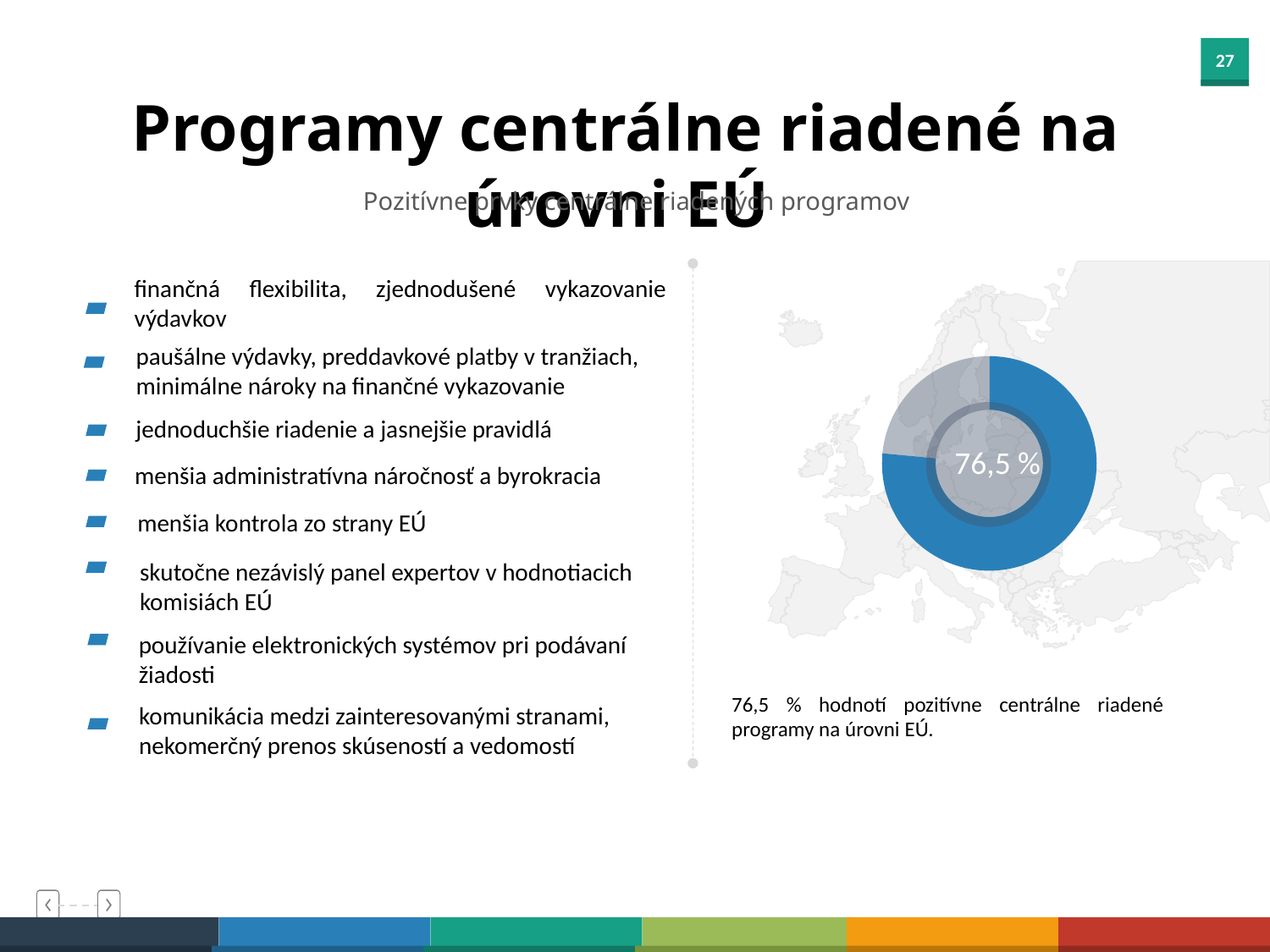
What share of respondents rate centrally managed programmes at EU level positively, according to the chart? 76,5 % What colour is the slice representing 76,5 % in the donut chart? Blue What kind of chart is shown on the right side of the slide? Pie (donut) chart How many slices does the donut chart have? 2 What value is printed in the centre of the donut chart? 76,5 % What image is shown in the background behind the donut chart? A map of Europe Which slice of the donut chart is larger, the blue one or the grey one? The blue one Which slice of the donut chart is the smallest? The grey slice